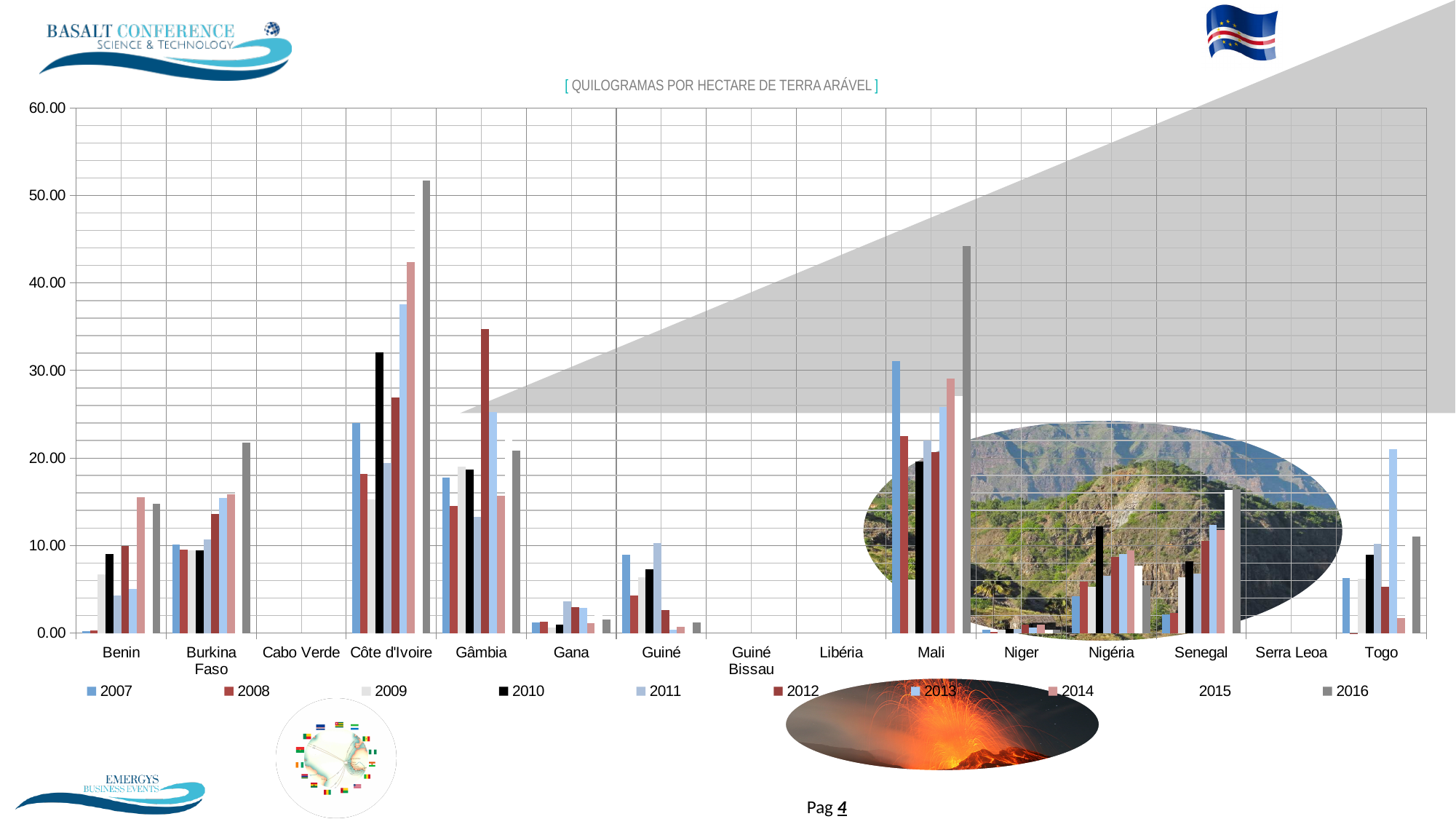
How many series (years) does the chart legend list? 10 For Côte d'Ivoire, which year has the highest value? 2016 For Mali, which year has the highest value? 2016 For Gâmbia, which year has the highest value? 2012 Is the value for Gana in 2011 greater or less than 10? less Is the value for Mali in 2016 greater or less than 40? greater Which is larger: the 2016 value for Côte d'Ivoire or the 2016 value for Mali? Côte d'Ivoire Is the value for Côte d'Ivoire in 2016 greater or less than 50? greater What kind of chart is shown on the slide? bar chart How many countries are shown along the x axis of the chart? 15 What is the title of the chart? [ QUILOGRAMAS POR HECTARE DE TERRA ARÁVEL ]